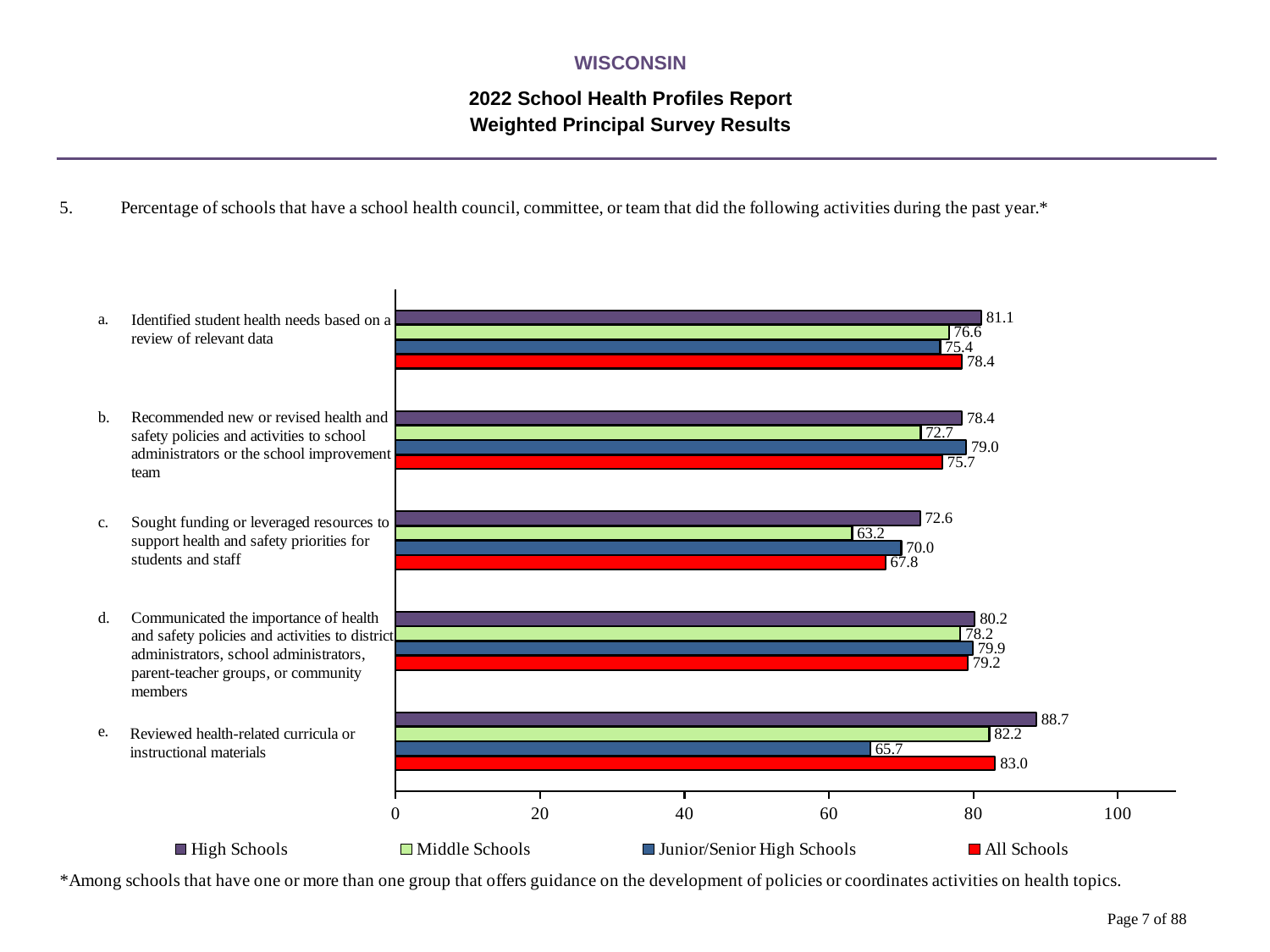
Which series is shown in red in the legend? All Schools Which activity has the highest value for High Schools? e. Reviewed health-related curricula or instructional materials How many series does the legend list? 4 Which activity has the lowest value for All Schools? c. Sought funding or leveraged resources to support health and safety priorities for students and staff What kind of chart is shown on the slide? Bar chart For activity b, 'Recommended new or revised health and safety policies', which is larger: the High Schools value or the Middle Schools value? High Schools What is the difference between the High Schools and Junior/Senior High Schools values for activity e, 'Reviewed health-related curricula or instructional materials'? 23.0 What is the value for All Schools for activity a, 'Identified student health needs based on a review of relevant data'? 78.4 What is the value for Junior/Senior High Schools for activity b, 'Recommended new or revised health and safety policies and activities to school administrators or the school improvement team'? 79.0 What is the value for Middle Schools for activity c, 'Sought funding or leveraged resources to support health and safety priorities for students and staff'? 63.2 How many activities (categories) are shown in the chart? 5 What is the value for High Schools for activity e, 'Reviewed health-related curricula or instructional materials'? 88.7